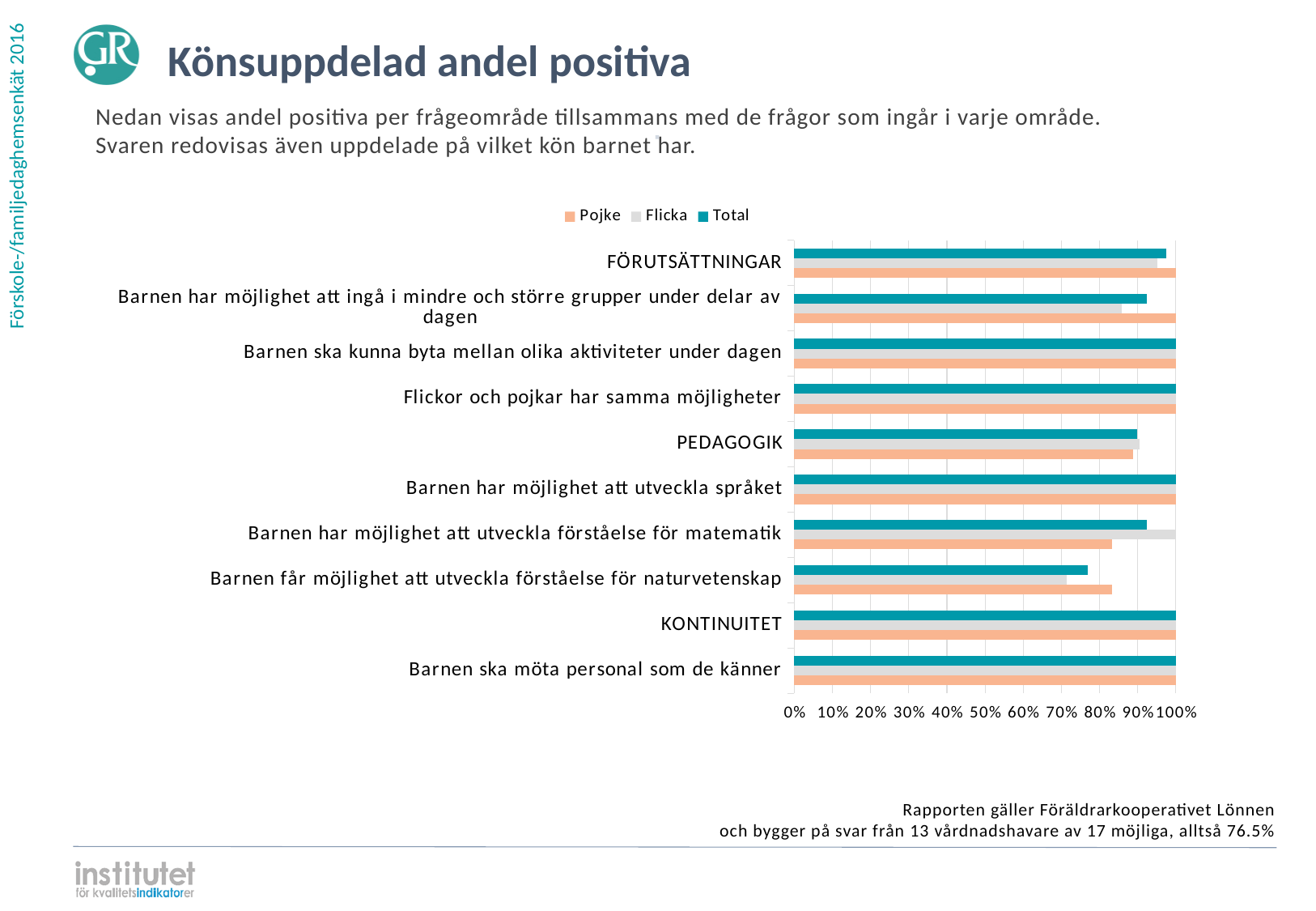
What is the Total value for 'Barnen ska kunna byta mellan olika aktiviteter under dagen'? 100% Is the Total value for 'Barnen får möjlighet att utveckla förståelse för naturvetenskap' greater or less than 70%? greater What kind of chart is shown on the slide? Bar chart How many categories are plotted on the y axis of the chart? 10 What is the Flicka value for 'Barnen har möjlighet att utveckla förståelse för matematik'? 100% Is the Pojke value for 'Barnen har möjlighet att utveckla förståelse för matematik' greater or less than 90%? less What is the Pojke value for FÖRUTSÄTTNINGAR? 100% Which series is shown in orange in the legend? Pojke For 'Barnen får möjlighet att utveckla förståelse för naturvetenskap', which is larger, the Pojke value or the Flicka value? Pojke How many series does the legend list? 3 Which category has the lowest Total value? Barnen får möjlighet att utveckla förståelse för naturvetenskap Is the Flicka value for 'Barnen har möjlighet att ingå i mindre och större grupper under delar av dagen' greater or less than 90%? less